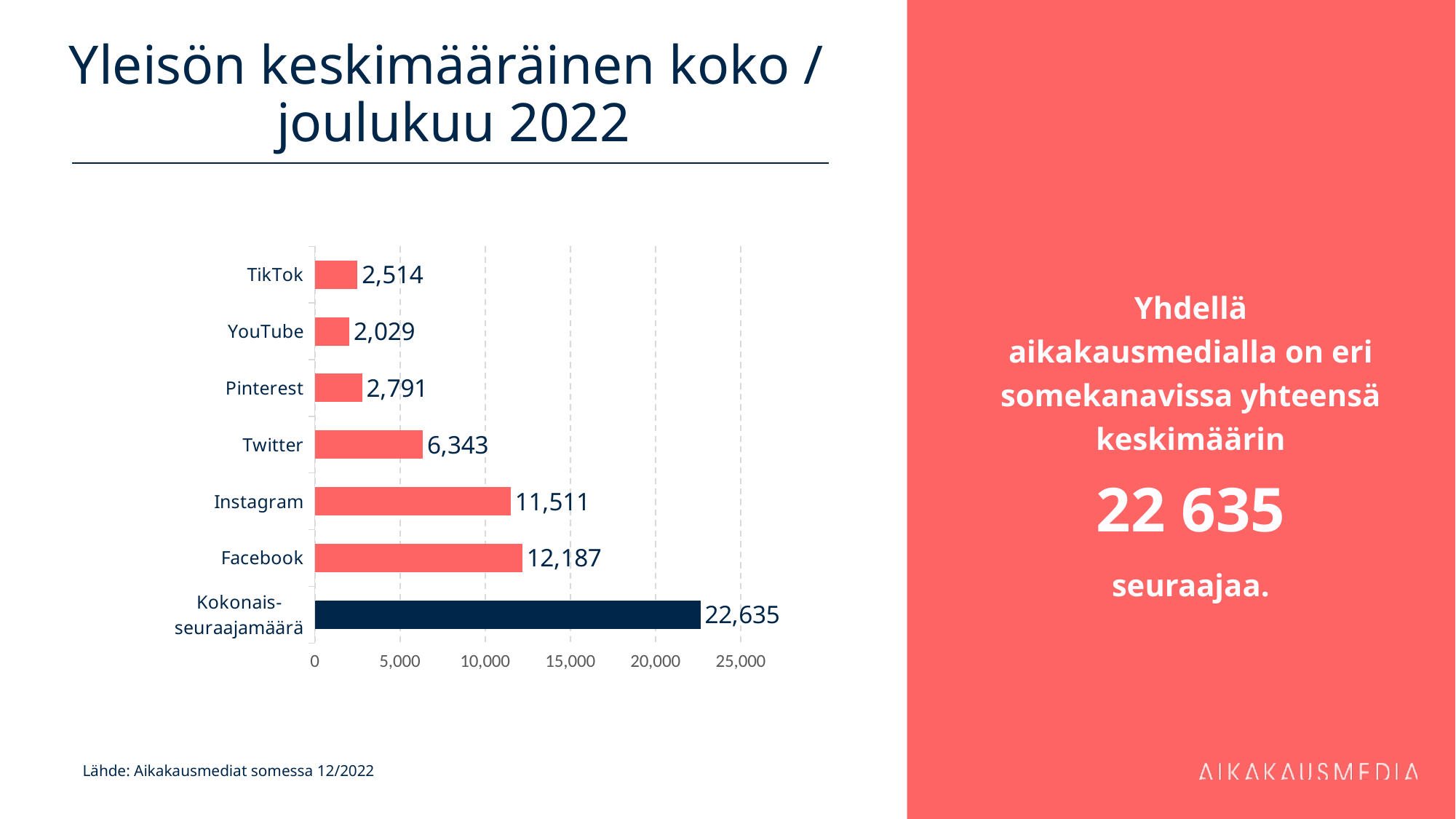
What is the value for Facebook? 12,187 What is the value for Instagram? 11,511 Which is larger, the value for Pinterest or the value for YouTube? Pinterest How many categories are shown in the chart? 7 Which category has the lowest value? YouTube What is the title of the slide? Yleisön keskimääräinen koko / joulukuu 2022 What is the value for Kokonais-seuraajamäärä? 22,635 Is the value for Twitter greater or less than 5,000? greater What is the difference between the values for Facebook and Instagram? 676 What is the value for TikTok? 2,514 Which category has the highest value? Kokonais-seuraajamäärä What kind of chart is shown on the slide? bar chart